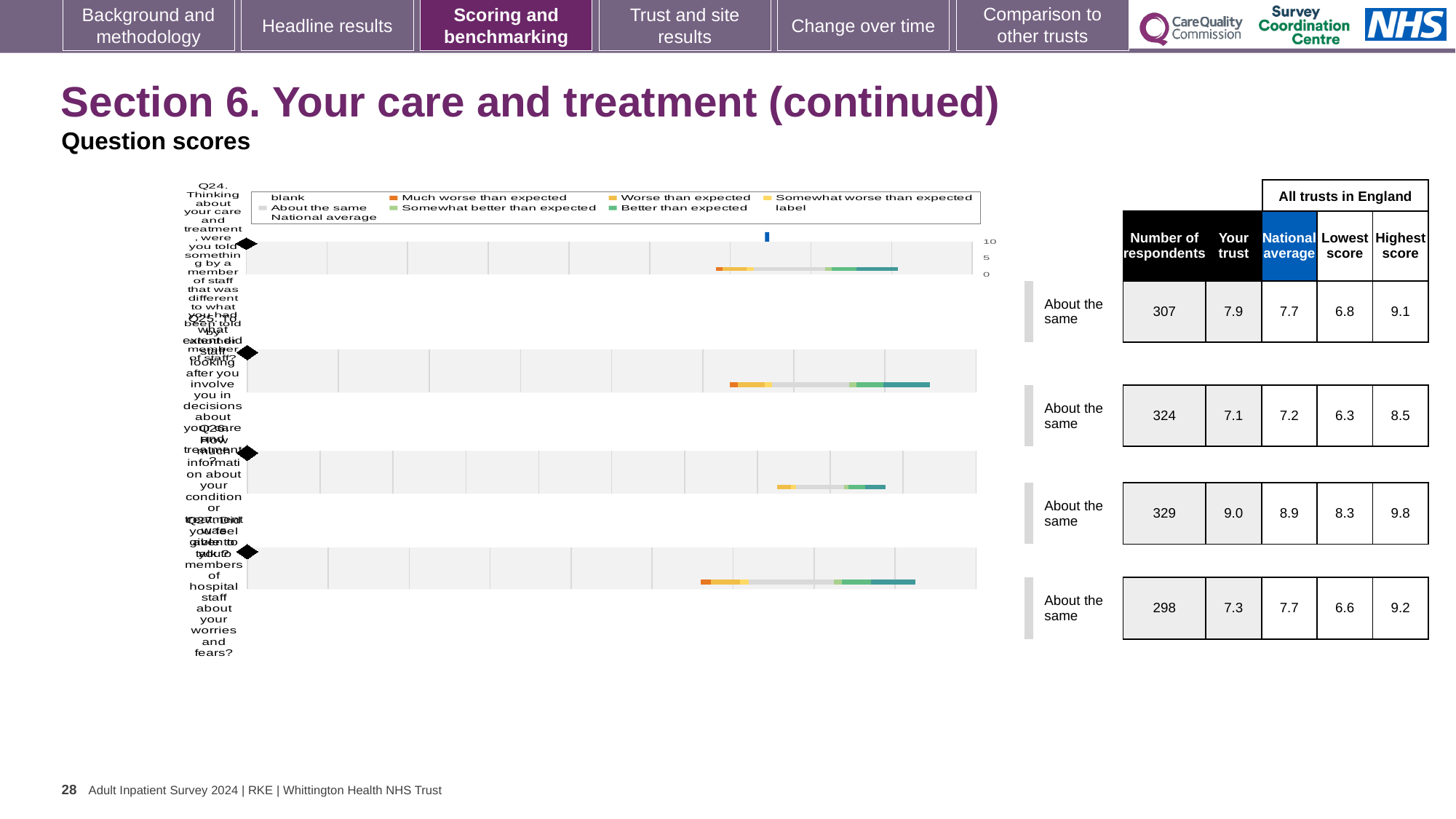
How many entries does the shared legend above the question charts list? 9 For the third row (Q26), which is larger: the 'Your trust' score or the national average? Your trust In the table beside the charts, what is the lowest score for the fourth row (Q27)? 6.6 In the table beside the charts, what is the number of respondents for the first row (Q24)? 307 What is the highest value shown on the axis at the right of the top chart? 10 In the table beside the charts, what is the 'Your trust' score for the first row (Q24)? 7.9 In the table beside the charts, what is the highest score for the third row (Q26)? 9.8 What kind of chart is used for the Q24 to Q27 question scores on this slide? bar chart For the first row (Q24), what is the difference between the highest score and the lowest score? 2.3 Which row in the table has the lowest number of respondents? Q27 (298) In the table beside the charts, what is the national average for the second row (Q25)? 7.2 How many question charts (Q24 to Q27) are shown on the slide? 4